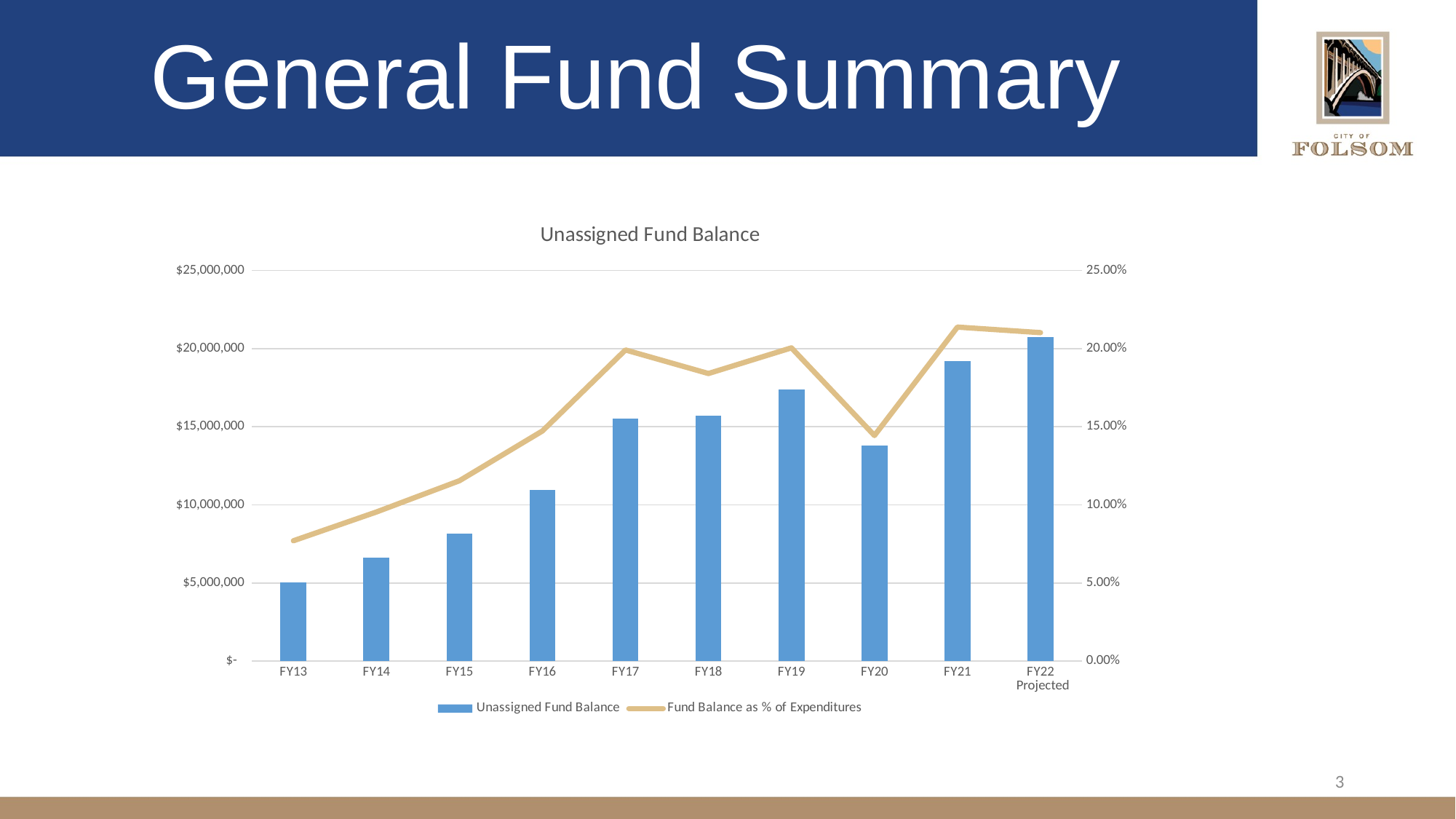
Is the Fund Balance as % of Expenditures for FY20 greater or less than 15.00%? less Is the Unassigned Fund Balance for FY20 greater or less than $15,000,000? less Is the Unassigned Fund Balance for FY16 greater or less than $10,000,000? greater Which fiscal year has the lowest Fund Balance as % of Expenditures? FY13 How many series does the legend list? 2 Which fiscal year has the lowest Unassigned Fund Balance bar? FY13 Which has the larger Unassigned Fund Balance, FY19 or FY20? FY19 Which fiscal year has the highest Unassigned Fund Balance bar? FY22 Projected What kind of chart is shown on the slide? A combined bar and line chart Which has the higher Fund Balance as % of Expenditures, FY18 or FY19? FY19 What is the title of the chart? Unassigned Fund Balance How many fiscal years are shown on the x axis? 10